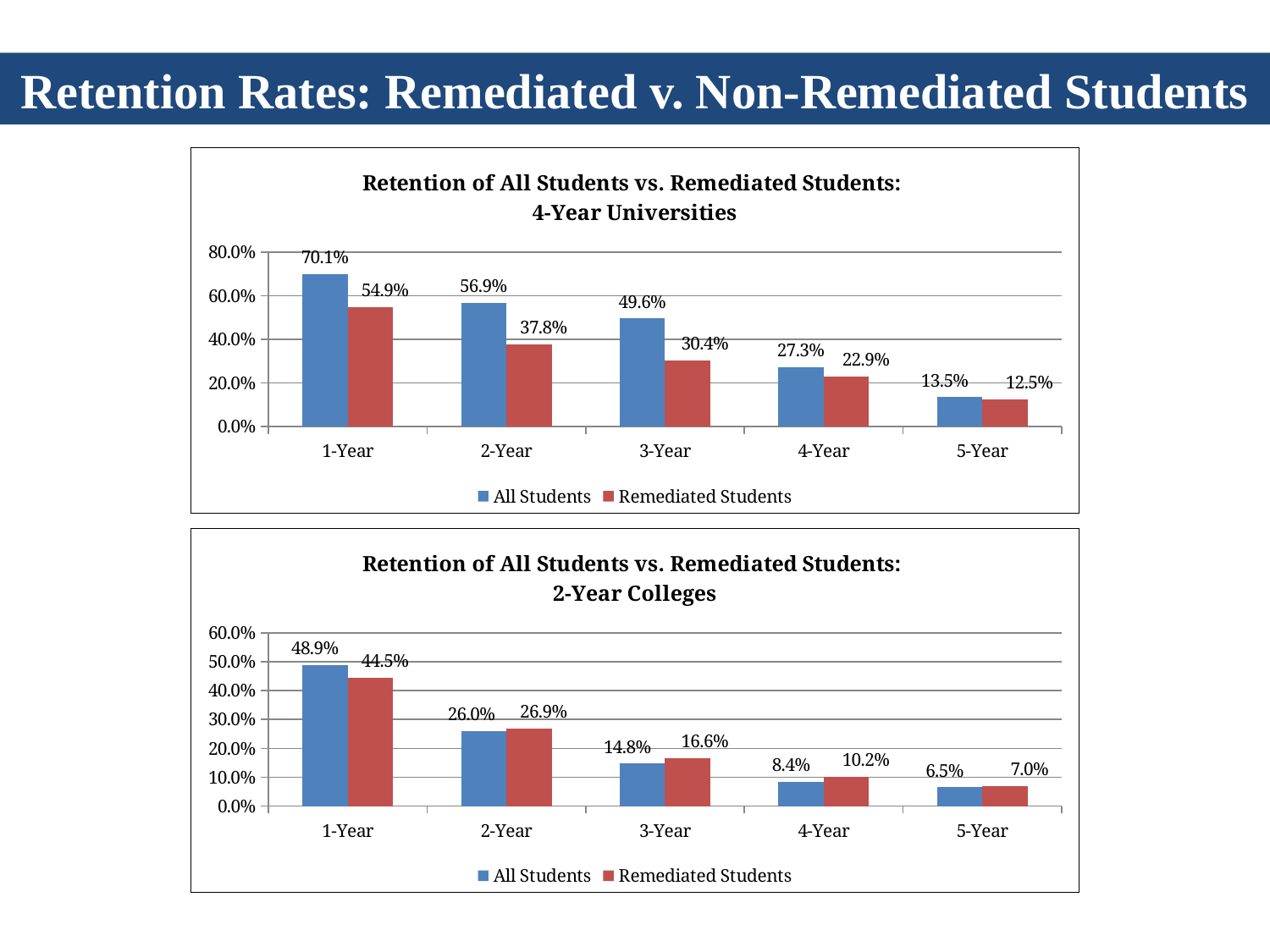
In the 2-Year Colleges chart, which category has the highest value for All Students? 1-Year In the 4-Year Universities chart, what is the retention rate for Remediated Students at 3-Year? 30.4% How many categories are shown on the x axis of the 2-Year Colleges chart? 5 What kind of chart is the 4-Year Universities chart? Bar chart In the 4-Year Universities chart, which category has the lowest value for Remediated Students? 5-Year In the 2-Year Colleges chart, what is the retention rate for Remediated Students at 2-Year? 26.9% How many series does the legend of the 4-Year Universities chart list? 2 In the 4-Year Universities chart, what is the retention rate for All Students at 1-Year? 70.1% In the 4-Year Universities chart, do the All Students values rise or fall from 1-Year to 5-Year? Fall In the 4-Year Universities chart, what is the difference between All Students and Remediated Students at 2-Year? 19.1% In the 2-Year Colleges chart, which is larger at 3-Year: All Students or Remediated Students? Remediated Students In the 2-Year Colleges chart, what is the retention rate for All Students at 4-Year? 8.4%